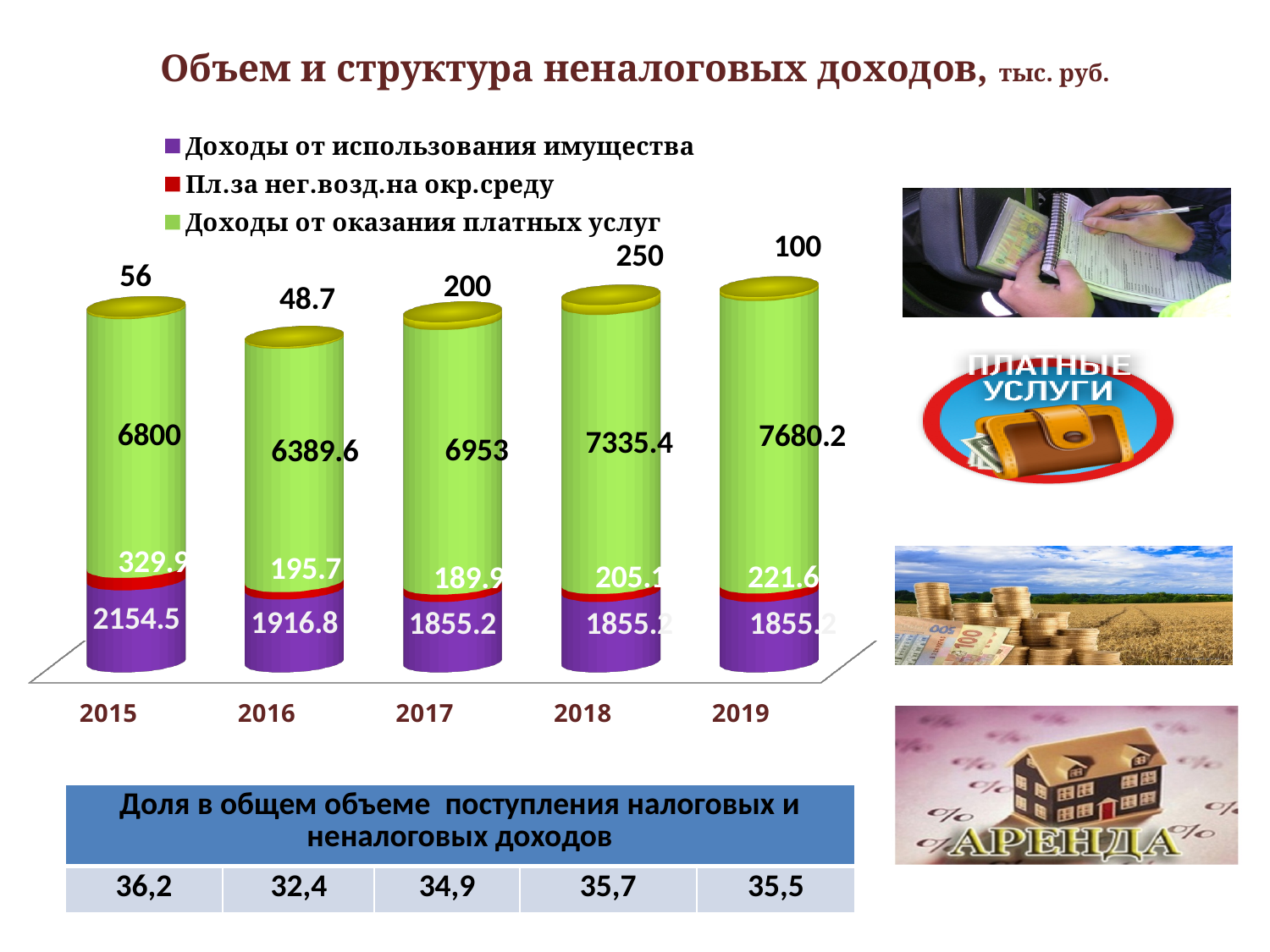
How many series does the chart legend list? 3 What is the value of Пл.за нег.возд.на окр.среду for 2018? 205.1 What is the difference between Доходы от использования имущества in 2015 and in 2016? 237.7 In which year is Доходы от оказания платных услуг the highest? 2019 What is the difference between Доходы от оказания платных услуг in 2019 and in 2018? 344.8 Which year has the larger value for Пл.за нег.возд.на окр.среду, 2015 or 2016? 2015 What is the value of Доходы от использования имущества for 2015? 2154.5 Does Доходы от оказания платных услуг rise or fall from 2016 to 2019? Rise In which year is Доходы от оказания платных услуг the lowest? 2016 How many years are shown on the x axis of the chart? 5 What kind of chart is shown on the slide? Stacked bar chart What is the value of Доходы от оказания платных услуг for 2019? 7680.2